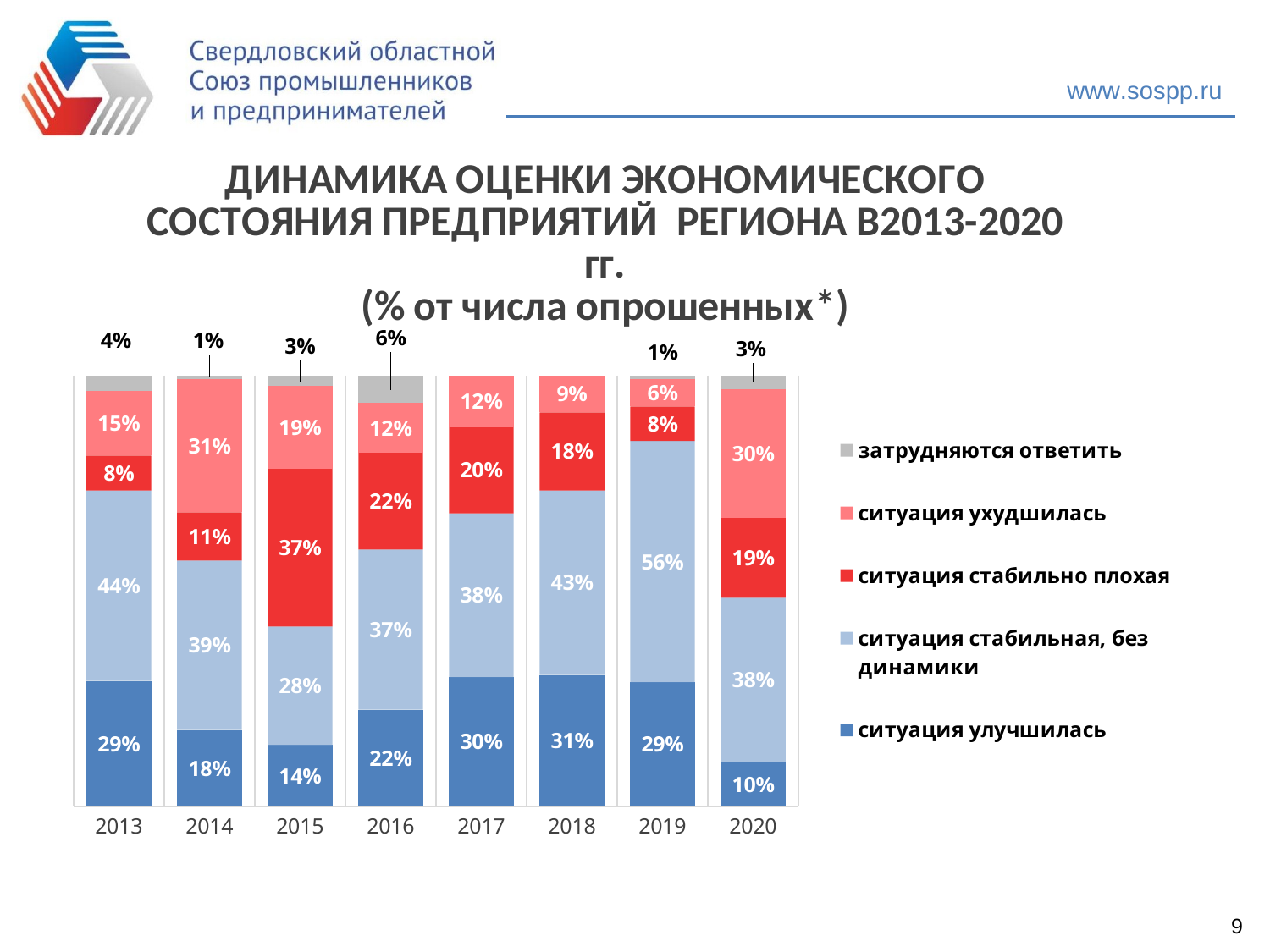
How many series does the legend list? 5 What is the difference between the 'ситуация ухудшилась' values in 2020 and 2019? 24% What is the value for 'ситуация улучшилась' in 2020? 10% What is the value for 'ситуация стабильно плохая' in 2015? 37% What is the value for 'ситуация ухудшилась' in 2014? 31% What type of chart is shown on the slide? stacked bar chart Which is larger: the 'ситуация стабильно плохая' value in 2016 or in 2018? 2016 In which year is the value for 'ситуация улучшилась' the lowest? 2020 What is the value for 'ситуация стабильная, без динамики' in 2019? 56% How many years are shown on the x axis? 8 Which colour represents 'затрудняются ответить' in the legend? grey In which year is the value for 'ситуация стабильная, без динамики' the highest? 2019